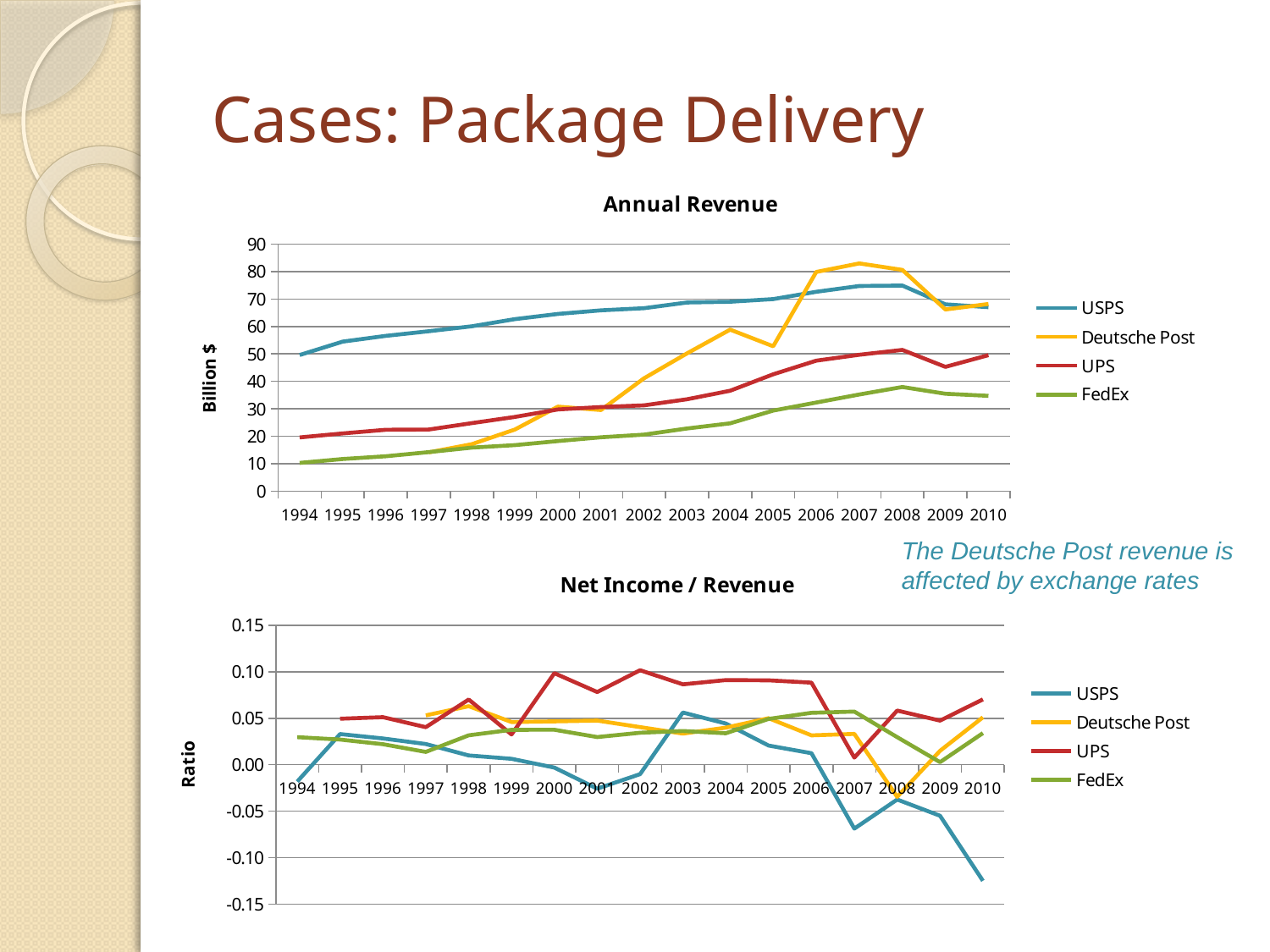
What kind of chart is the Annual Revenue chart? line chart In the Annual Revenue chart, is the value for USPS in 1994 greater or less than 40? greater What is the y-axis title of the Annual Revenue chart? Billion $ In the Net Income / Revenue chart, which company has the lowest ratio in 2010? USPS In the Annual Revenue chart, which company has the lowest revenue in 2010? FedEx In the Annual Revenue chart, which company has the highest revenue in 2007? Deutsche Post How many years are shown on the x axis of the Annual Revenue chart? 17 In the Annual Revenue chart, which is larger in 2004, Deutsche Post or UPS? Deutsche Post In the Net Income / Revenue chart, is the value for UPS in 2002 greater or less than 0.05? greater In the Annual Revenue chart, is the value for FedEx in 1994 greater or less than 20? less In the Annual Revenue chart, does FedEx revenue rise or fall from 1994 to 2008? rise How many series does the legend of the Annual Revenue chart list? 4